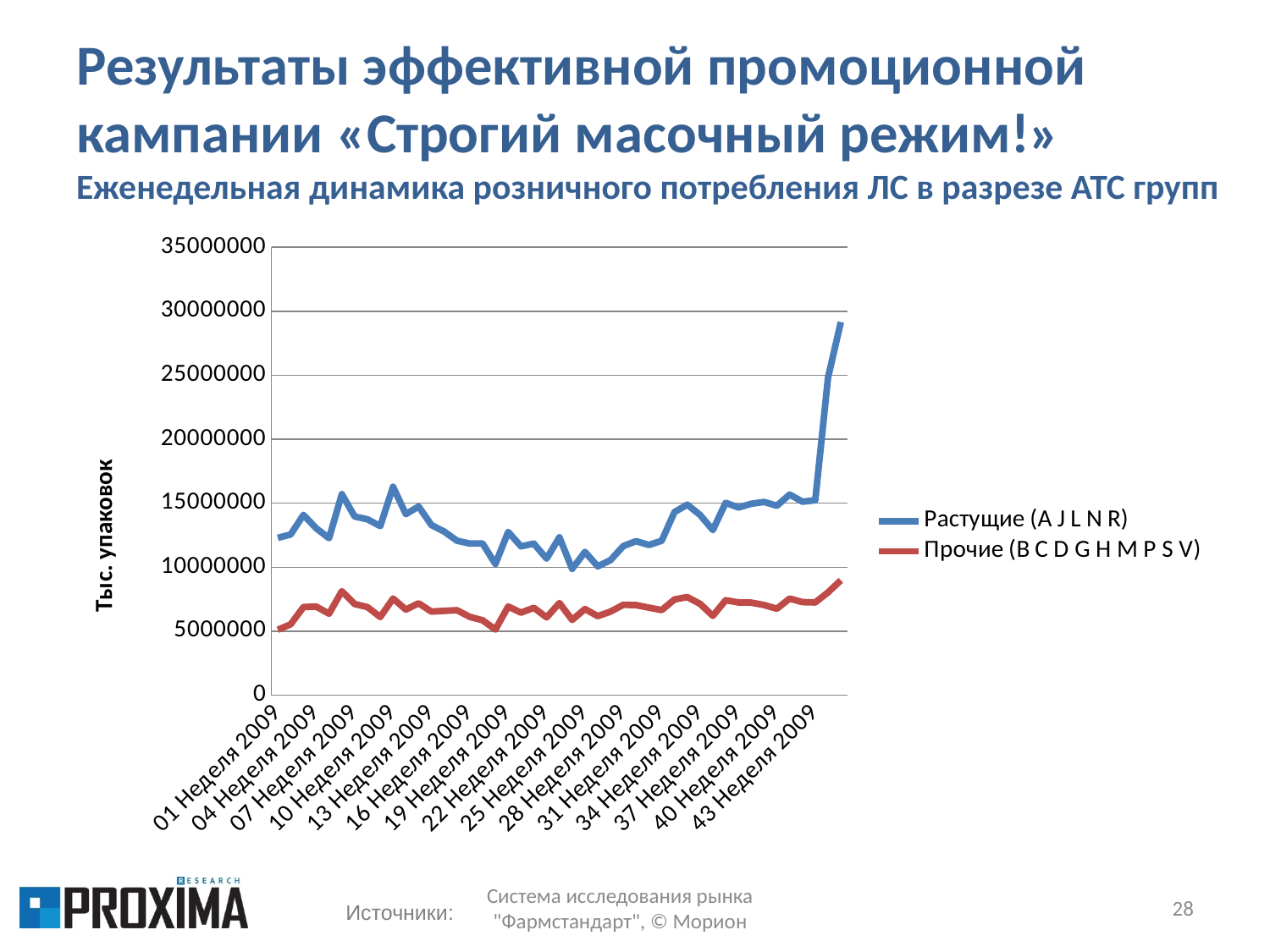
Does the Растущие (A J L N R) series rise or fall sharply at the end of the period? rise How many series does the legend list? 2 What is the label of the vertical axis? Тыс. упаковок What kind of chart is shown on the slide? line chart At 43 Неделя 2009, which series has the larger value, Растущие (A J L N R) or Прочие (B C D G H M P S V)? Растущие (A J L N R) What are the two series named in the legend? Растущие (A J L N R) and Прочие (B C D G H M P S V) Is the value of Прочие (B C D G H M P S V) at 43 Неделя 2009 greater or less than 10000000? less Is the value of Растущие (A J L N R) at 01 Неделя 2009 greater or less than 10000000? greater Is the value of Растущие (A J L N R) at 43 Неделя 2009 greater or less than 25000000? less Which series reaches the highest value on the chart? Растущие (A J L N R)